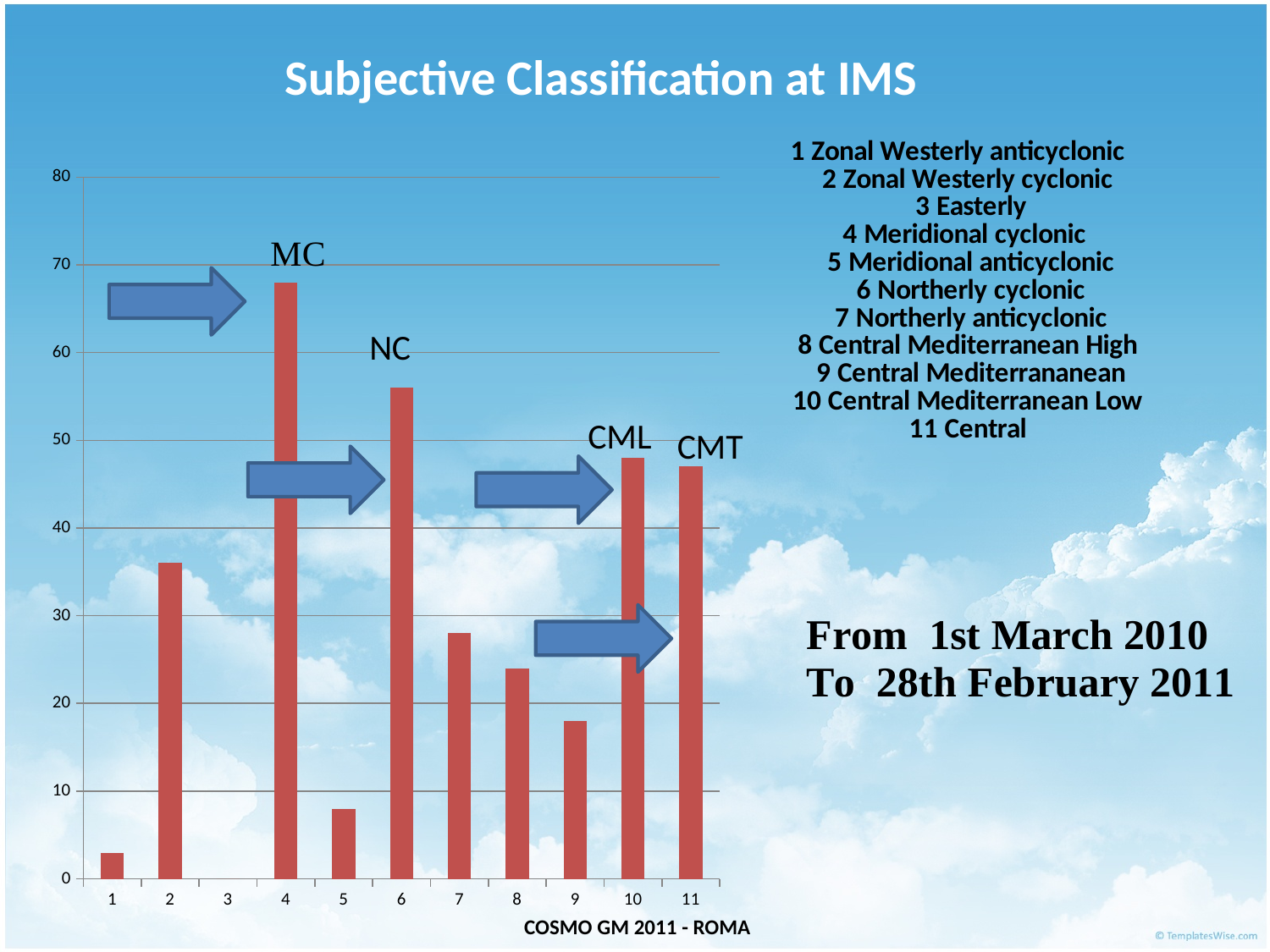
Which category has the shortest visible bar in the chart? 1 Is the value for category 5 greater or less than 10? less Which category has no visible bar in the chart? 3 Is the value for category 4 greater or less than 60? greater What is the title of the slide containing the chart? Subjective Classification at IMS Which has the larger value, category 4 or category 6? category 4 Which has the larger value, category 2 or category 7? category 2 How many categories are shown on the x axis of the chart? 11 What kind of chart is shown on the slide? bar chart Which category has the tallest bar in the chart? 4 What label is written above the bar for category 4? MC Is the value for category 2 greater or less than 40? less